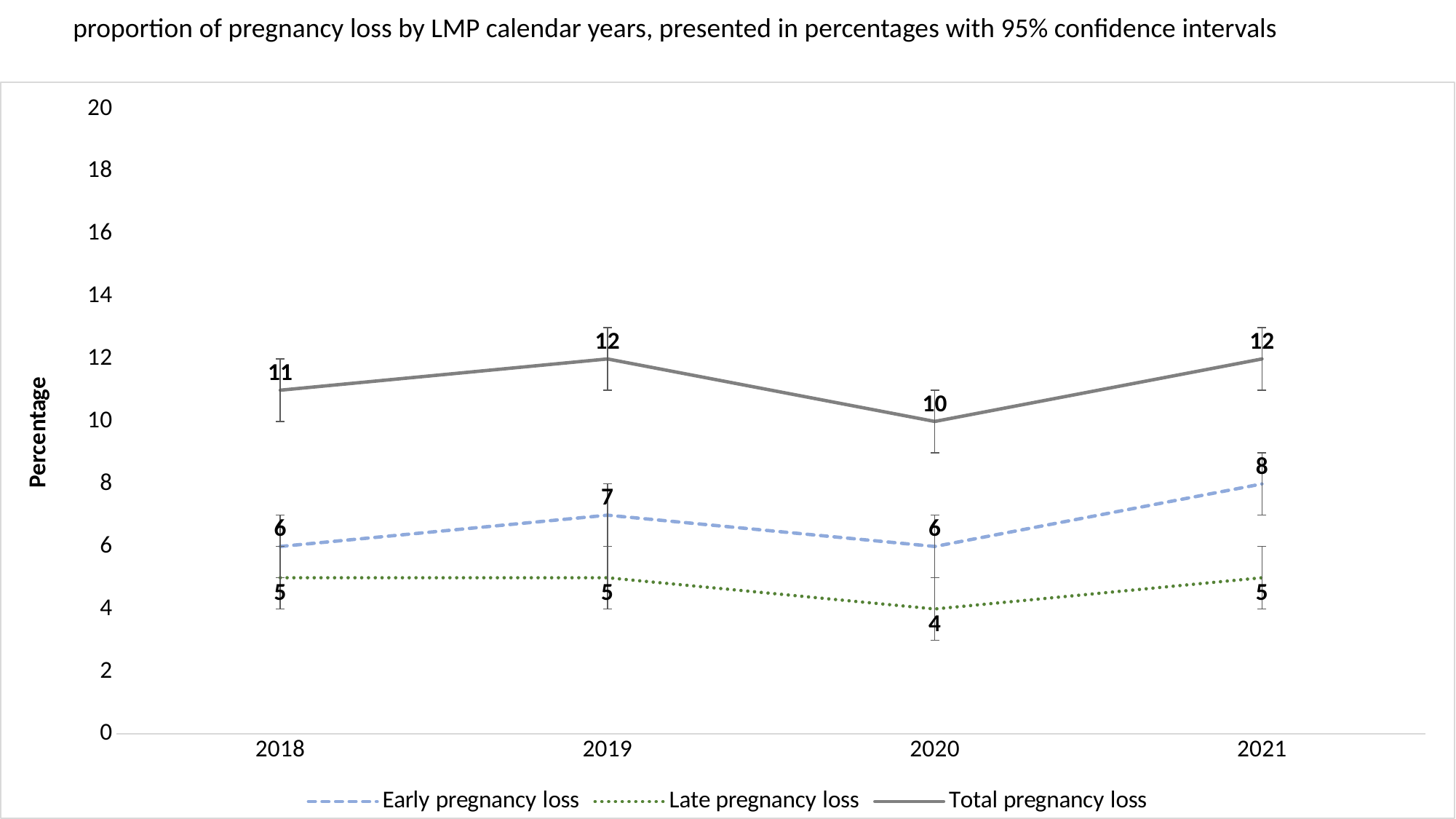
How many years are shown on the x axis? 4 What is the value for Early pregnancy loss in 2021? 8 Which is larger in 2018: Early pregnancy loss or Late pregnancy loss? Early pregnancy loss In which year is Early pregnancy loss highest? 2021 What kind of chart is this? Line chart What is the difference between Total pregnancy loss and Early pregnancy loss in 2019? 5 What is the value for Late pregnancy loss in 2020? 4 How many series does the legend list? 3 In which year is Total pregnancy loss lowest? 2020 What is the value for Total pregnancy loss in 2018? 11 What is the value for Total pregnancy loss in 2020? 10 What is the label of the y axis? Percentage